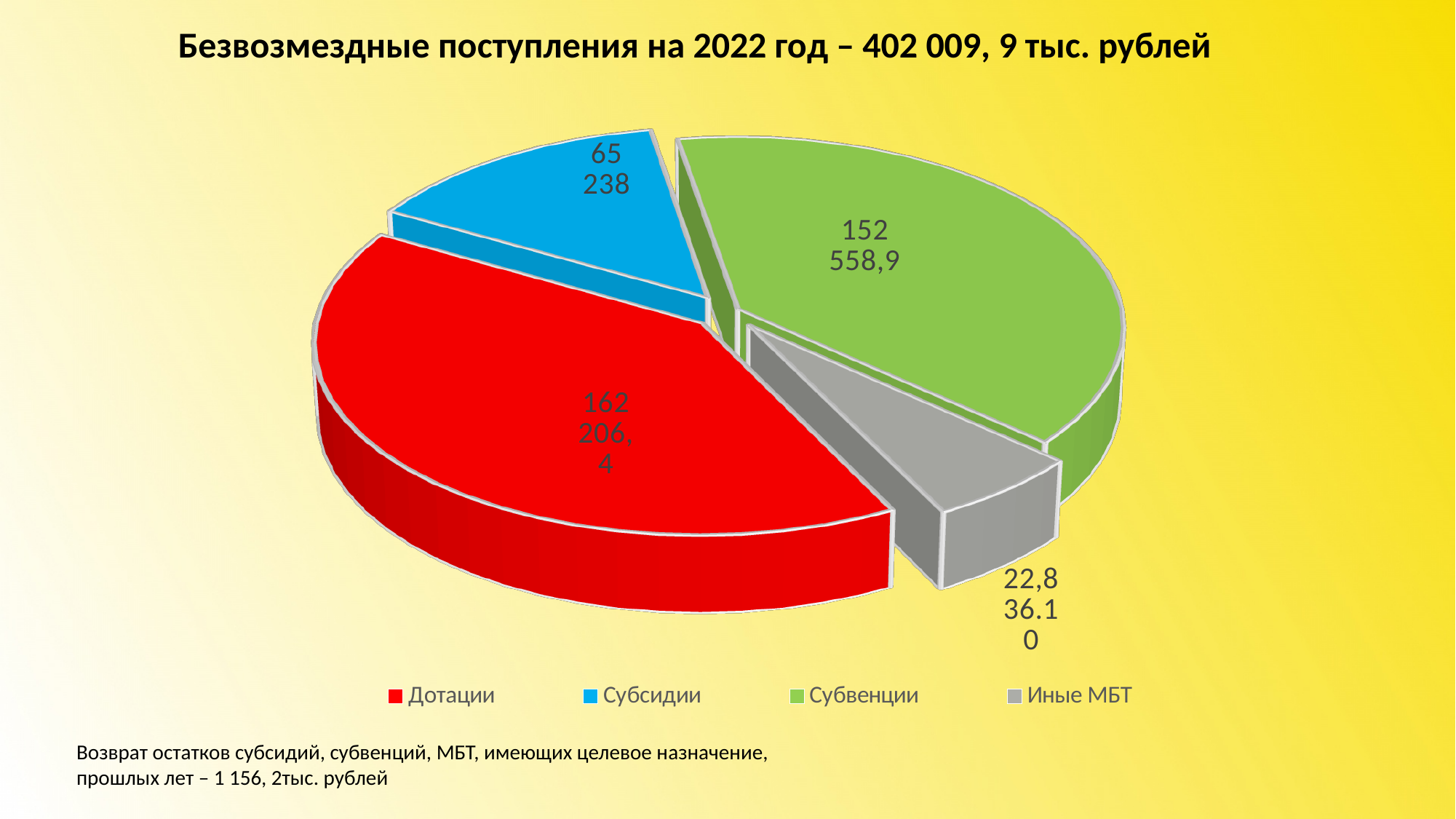
Which category has the smallest slice of the pie? Иные МБТ What kind of chart is shown on the slide? pie chart What is the difference between the values for Субвенции and Субсидии? 87 320,9 What is the difference between the values for Дотации and Субвенции? 9 647,5 How many slices does the pie chart have? 4 What is the value shown for Субсидии? 65 238 Which is larger, Субсидии or Субвенции? Субвенции What is the value shown for Дотации? 162 206,4 What colour is the Дотации slice in the pie chart? red Which category has the largest slice of the pie? Дотации What is the value shown for Субвенции? 152 558,9 How many entries does the legend list? 4